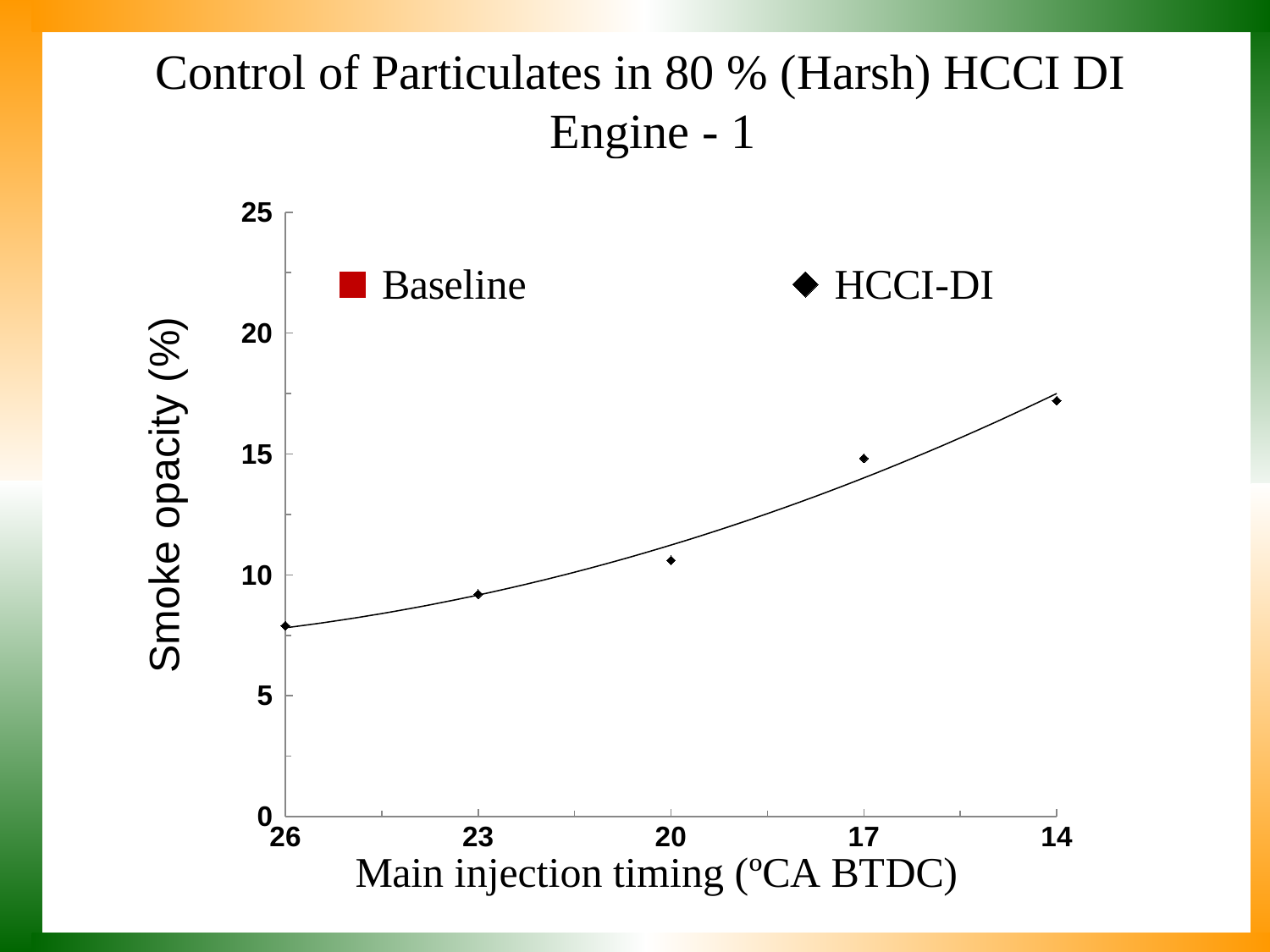
Is the HCCI-DI smoke opacity at 14 °CA BTDC greater or less than 15? greater What kind of chart is shown on the slide? scatter chart with a trend line Is the HCCI-DI smoke opacity at 26 °CA BTDC greater or less than 10? less Which has the higher HCCI-DI smoke opacity: 17 °CA BTDC or 23 °CA BTDC? 17 °CA BTDC Do the HCCI-DI smoke opacity values rise or fall as you move from left to right along the x axis (from 26 to 14 °CA BTDC)? rise How many series does the legend list? 2 What is the label of the y axis? Smoke opacity (%) At which main injection timing is the HCCI-DI smoke opacity lowest? 26 At which main injection timing is the HCCI-DI smoke opacity highest? 14 Is the HCCI-DI smoke opacity at 20 °CA BTDC greater or less than 10? greater How many HCCI-DI data points are plotted on the chart? 5 What marker symbol does the legend use for the HCCI-DI series? black diamond